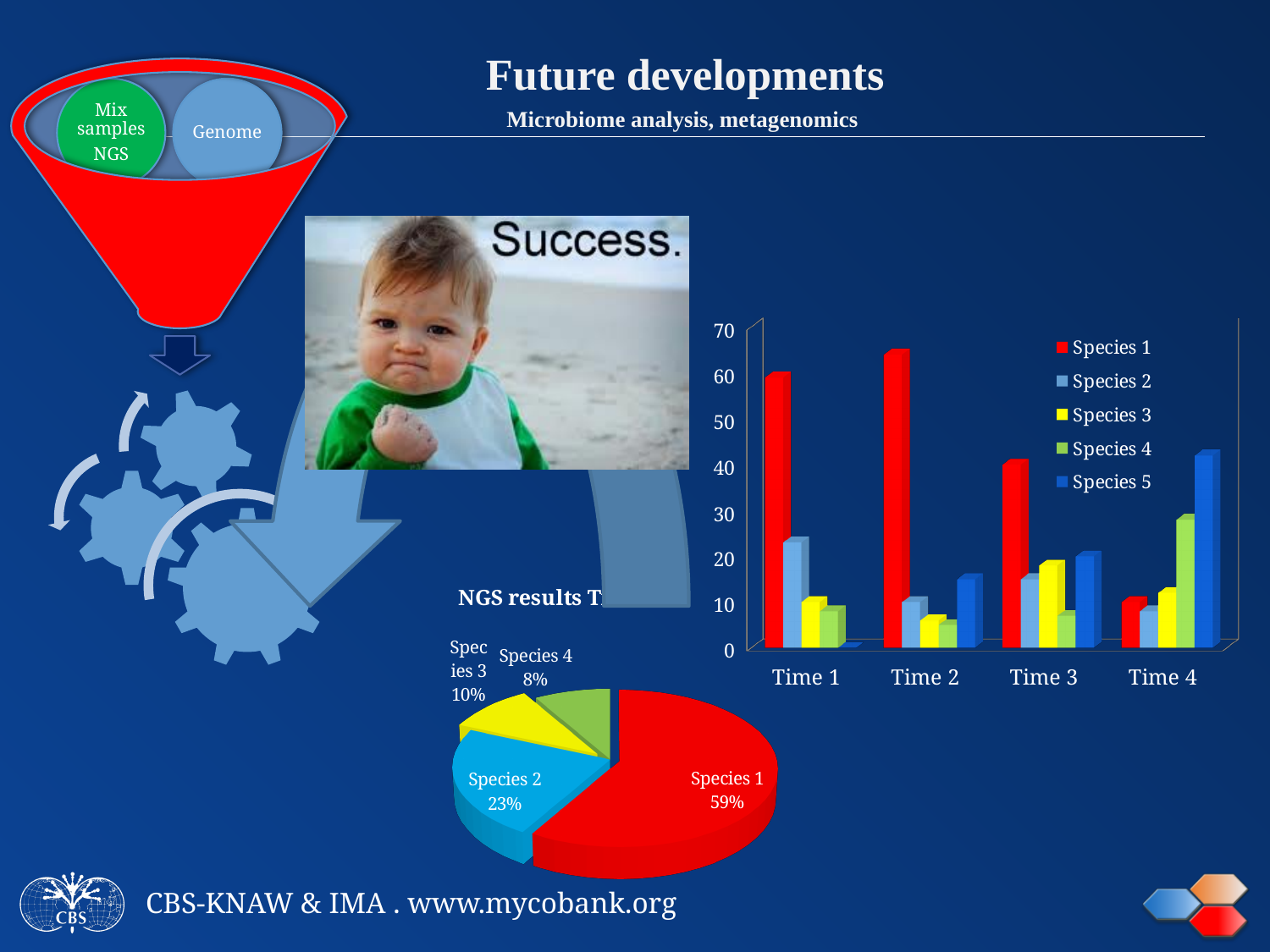
In the bar chart on the right, how many series does the legend list? 5 In the bar chart on the right, which species has the highest bar at Time 2? Species 1 In the pie chart at the bottom of the slide, how many slices are there? 4 In the bar chart on the right, which species has the highest bar at Time 4? Species 5 In the pie chart at the bottom of the slide, which species has the smallest slice? Species 4 In the pie chart at the bottom of the slide, what share does Species 2 have? 23% In the bar chart on the right, how many time categories are shown on the x axis? 4 In the pie chart at the bottom of the slide, what share does Species 1 have? 59% What kind of chart is the chart on the right of the slide with Time 1 to Time 4 on the x axis? bar chart In the bar chart on the right, does the value for Species 5 rise or fall from Time 1 to Time 4? rise In the bar chart on the right, is the value for Species 1 at Time 2 greater or less than 60? greater In the bar chart on the right, is the value for Species 1 at Time 4 greater or less than 20? less